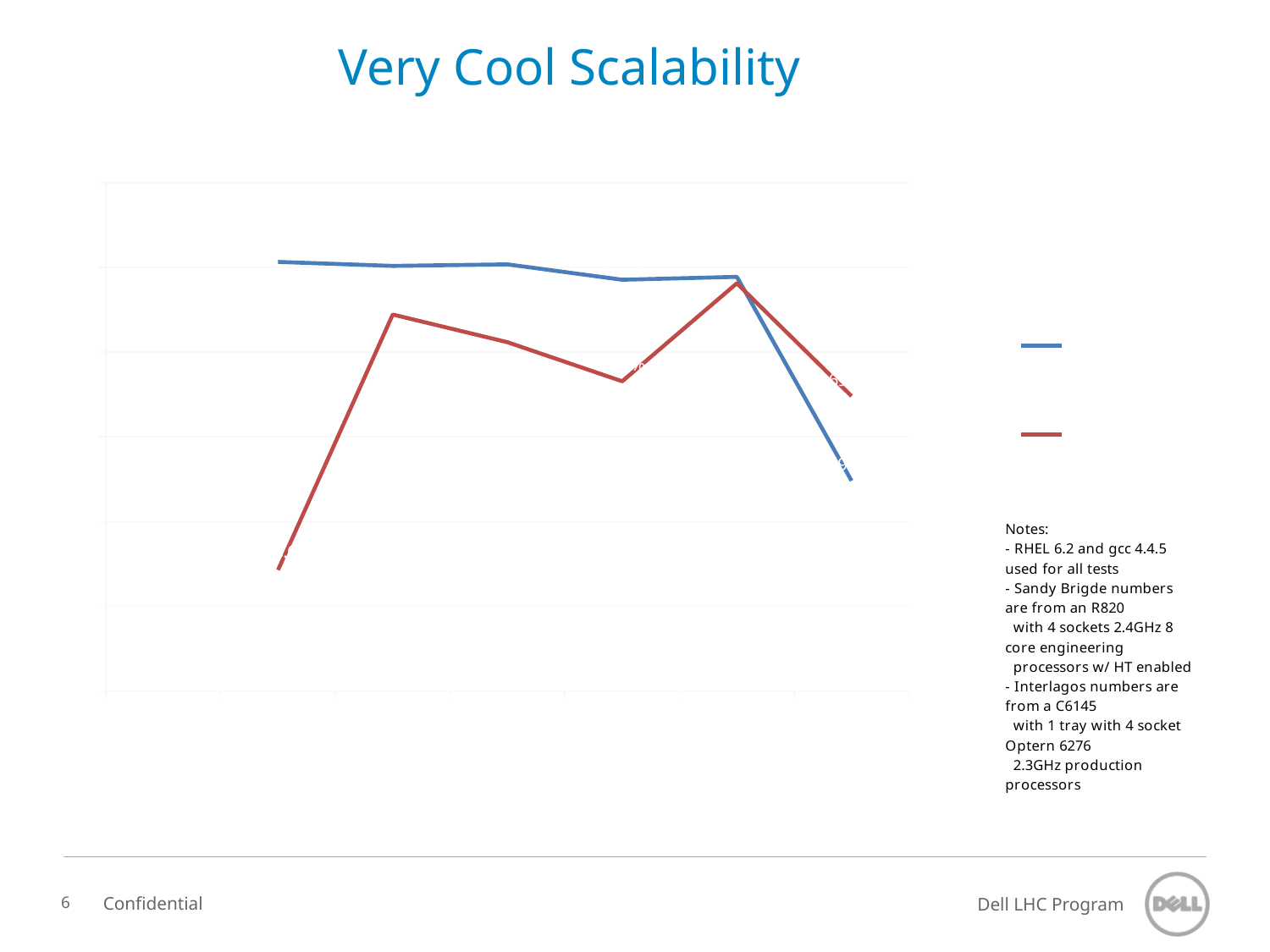
Does the blue line rise or fall between its fifth and sixth points? fall How many data points does the blue line have? 6 At which point along the x axis is the blue line at its lowest? the last (rightmost) point What kind of chart is shown on the slide? line chart How many series does the legend list? 2 At the leftmost point, which line is higher, the blue line or the red line? blue How many data points does the red line have? 6 What colours are the two lines in the chart? blue and red At the rightmost point, which line is higher, the blue line or the red line? red Does the red line rise or fall between its first and second points? rise What is the title of the slide containing the chart? Very Cool Scalability At which point along the x axis is the red line at its lowest? the first (leftmost) point